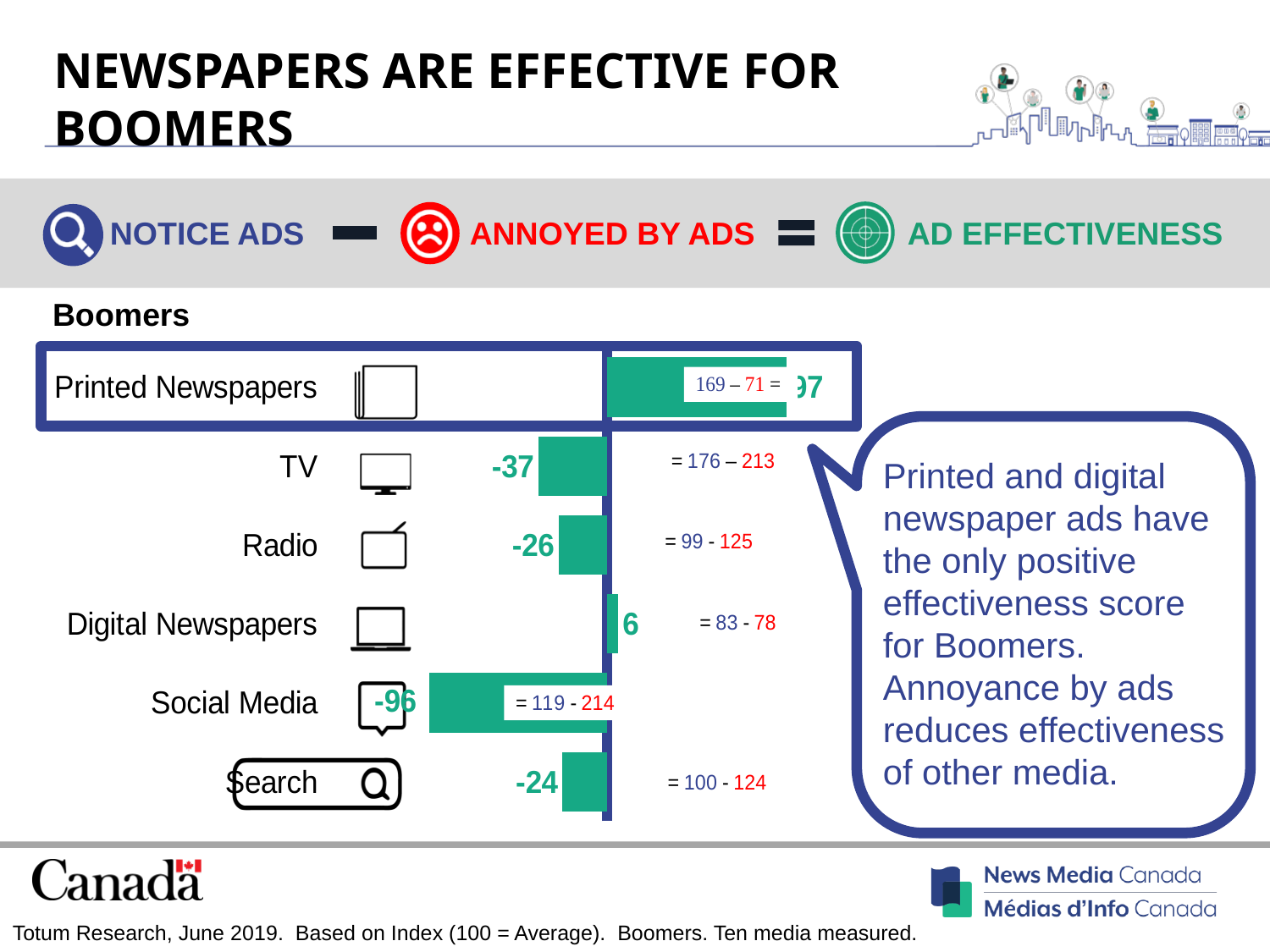
Which generation group does the chart cover, according to the label above it? Boomers Which has the larger ad effectiveness value, Digital Newspapers or Search? Digital Newspapers What is the difference between the values for Radio and TV? 11 How many media categories are plotted in the chart? 6 Which has the larger ad effectiveness value, TV or Radio? Radio What kind of chart is shown on the slide? bar chart What is the ad effectiveness value for TV? -37 What is the ad effectiveness value for Search? -24 What is the ad effectiveness value for Digital Newspapers? 6 Which media category has the highest ad effectiveness value? Printed Newspapers Which media category has the lowest ad effectiveness value? Social Media What is the ad effectiveness value for Radio? -26